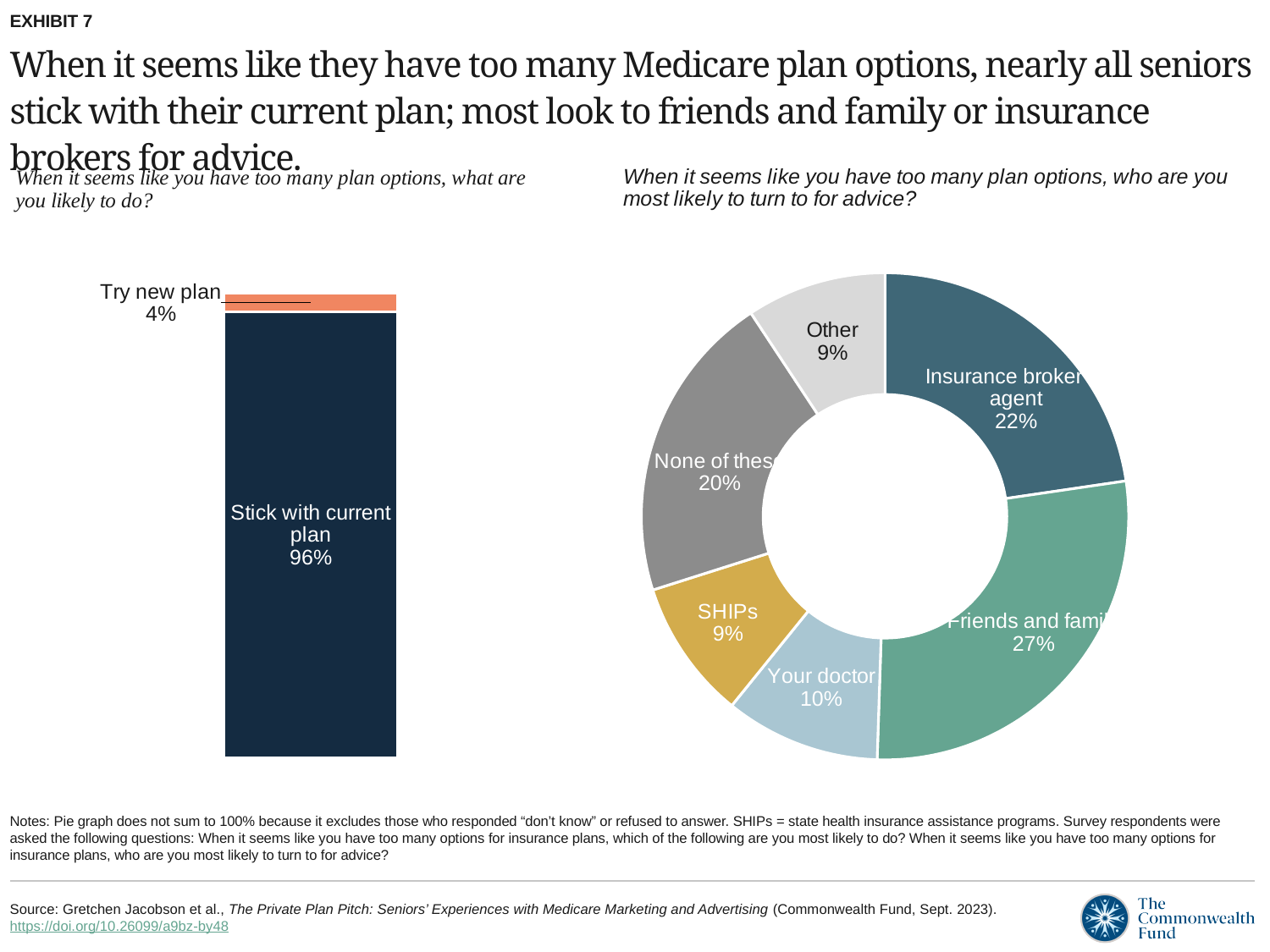
In the right chart, what percentage of seniors turn to friends and family for advice? 27% In the right chart, what percentage of seniors turn to their doctor for advice? 10% In the left chart, what percentage of seniors say they would try a new plan? 4% In the left chart, what is the difference between the share who stick with their current plan and the share who try a new plan? 92 percentage points In the right chart, what is the difference between the share for Friends and family and the share for Insurance broker/agent? 5 percentage points What kind of chart is shown on the left side of the slide? Bar chart In the right chart, which is larger: the share for None of these or the share for Your doctor? None of these In the right chart, what percentage of seniors turn to an insurance broker/agent for advice? 22% How many slices does the right chart have? 6 In the right chart, which source of advice has the largest share? Friends and family What kind of chart is shown on the right side of the slide? Pie chart In the left chart, what percentage of seniors say they would stick with their current plan? 96%